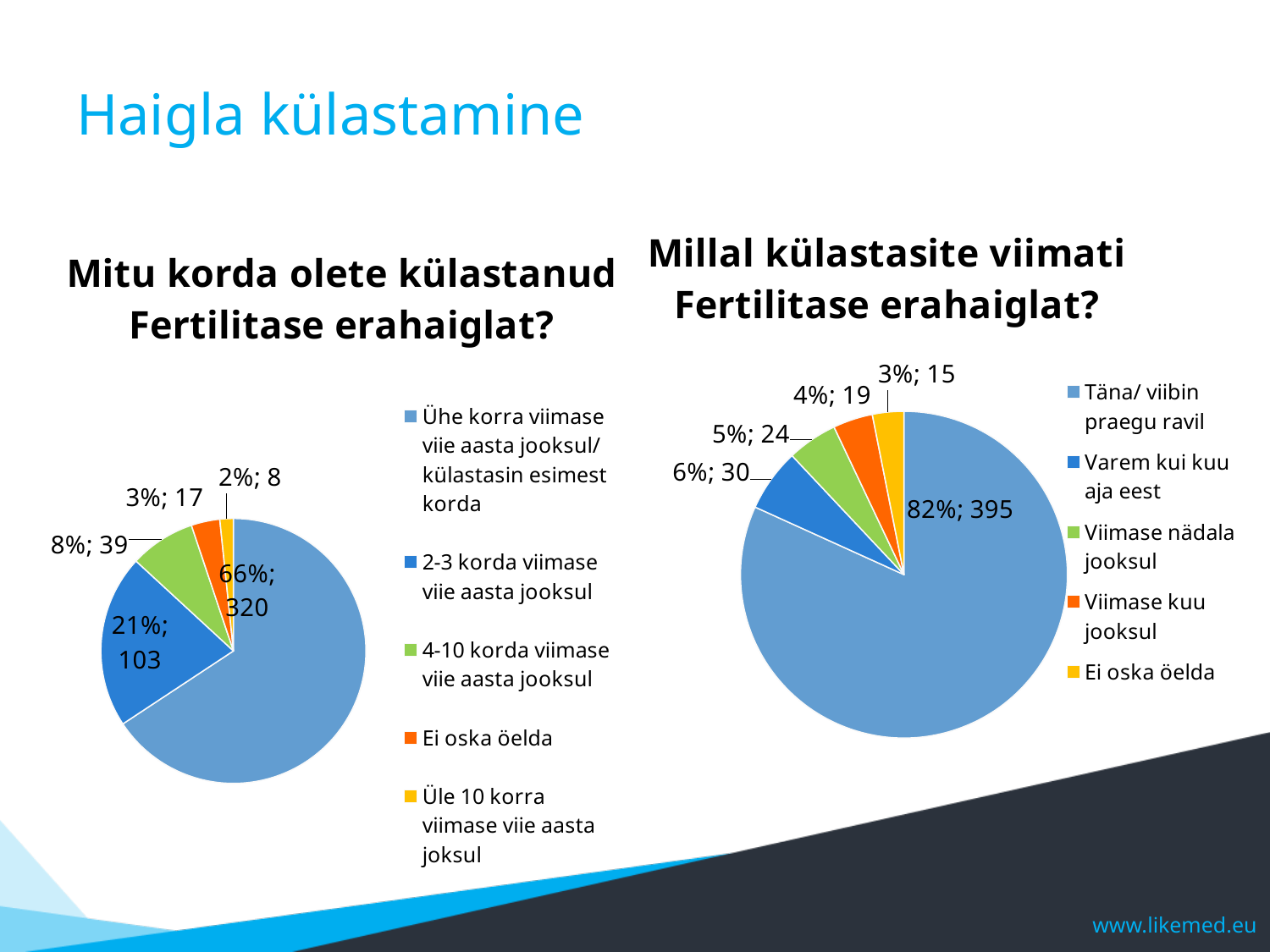
On the left pie chart (Mitu korda olete külastanud Fertilitase erahaiglat?), how many slices does the pie have? 5 On the left pie chart (Mitu korda olete külastanud Fertilitase erahaiglat?), what is the difference in counts between 'Ühe korra viimase viie aasta jooksul' and '2-3 korda viimase viie aasta jooksul'? 217 On the left pie chart (Mitu korda olete külastanud Fertilitase erahaiglat?), which category has the largest slice? Ühe korra viimase viie aasta jooksul/ külastasin esimest korda On the right pie chart (Millal külastasite viimati Fertilitase erahaiglat?), what count is shown for 'Täna/ viibin praegu ravil'? 395 On the left pie chart (Mitu korda olete külastanud Fertilitase erahaiglat?), what count is shown for '2-3 korda viimase viie aasta jooksul'? 103 On the left pie chart (Mitu korda olete külastanud Fertilitase erahaiglat?), what percentage is shown for '4-10 korda viimase viie aasta jooksul'? 8% What type of chart is used on the right side of the slide (Millal külastasite viimati Fertilitase erahaiglat?)? Pie chart On the right pie chart (Millal külastasite viimati Fertilitase erahaiglat?), what percentage is shown for 'Viimase nädala jooksul'? 5% On the right pie chart (Millal külastasite viimati Fertilitase erahaiglat?), what share of the pie does 'Täna/ viibin praegu ravil' take? 82% On the left pie chart (Mitu korda olete külastanud Fertilitase erahaiglat?), which category has the smallest slice? Üle 10 korra viimase viie aasta joksul On the right pie chart (Millal külastasite viimati Fertilitase erahaiglat?), which is larger: 'Varem kui kuu aja eest' or 'Viimase kuu jooksul'? Varem kui kuu aja eest On the right pie chart (Millal külastasite viimati Fertilitase erahaiglat?), which category has the smallest slice? Ei oska öelda